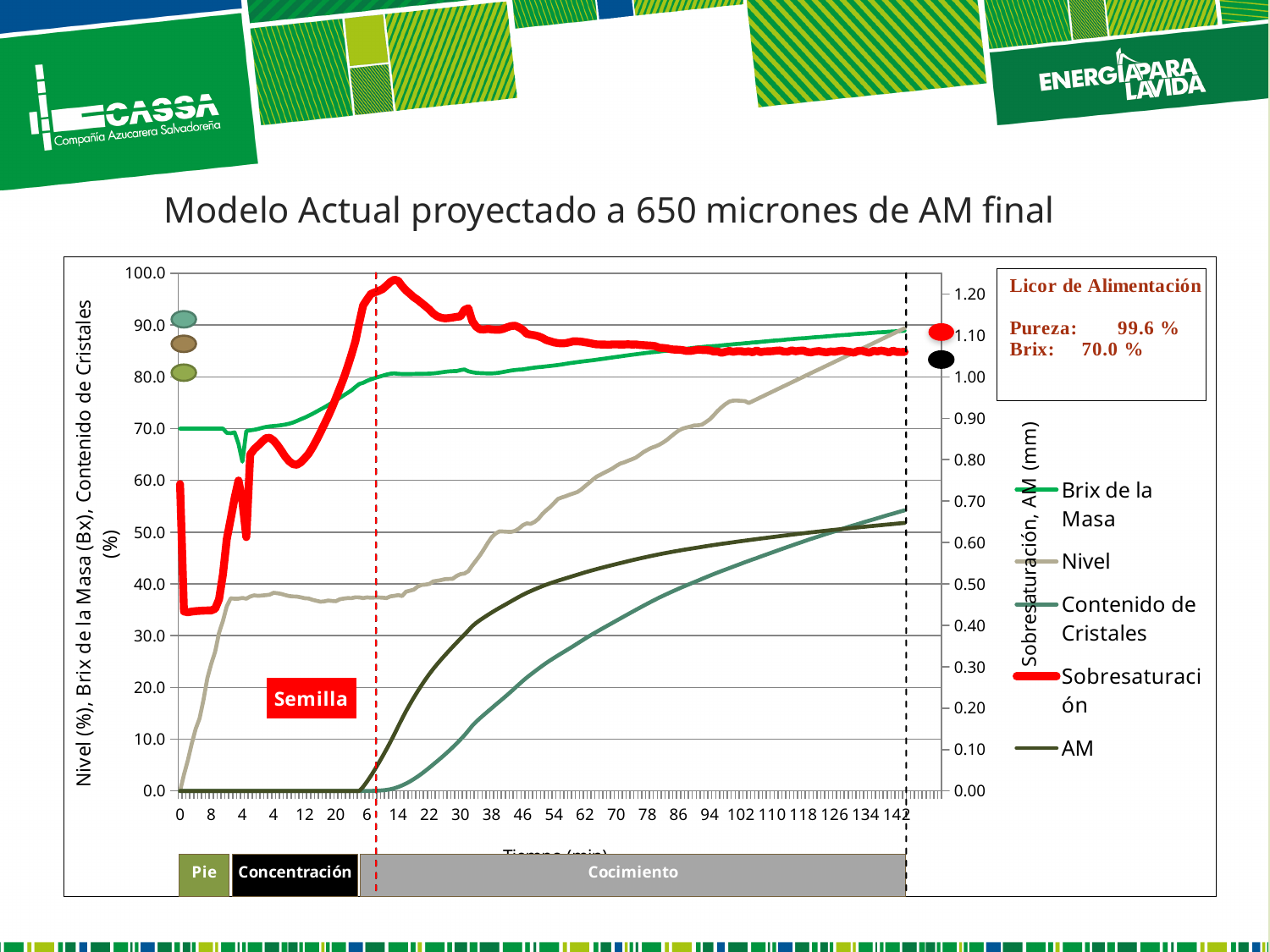
At the end of the chart, which is larger: Nivel or Contenido de Cristales? Nivel Is the value of Nivel at the start of the chart (time 0) greater or less than 10.0? less What is the label of the right-hand vertical axis? Sobresaturación, AM (mm) Does the Contenido de Cristales series rise or fall along the x axis? rise Is the value of Sobresaturación at the end of the chart greater or less than 1.00 on the right axis? greater Does the Nivel series rise or fall along the x axis? rise Is the value of AM at the end of the chart greater or less than 0.60 on the right axis? greater How many series does the chart legend list? 5 What kind of chart is shown on the slide? line chart What is the title of the slide's chart? Modelo Actual proyectado a 650 micrones de AM final